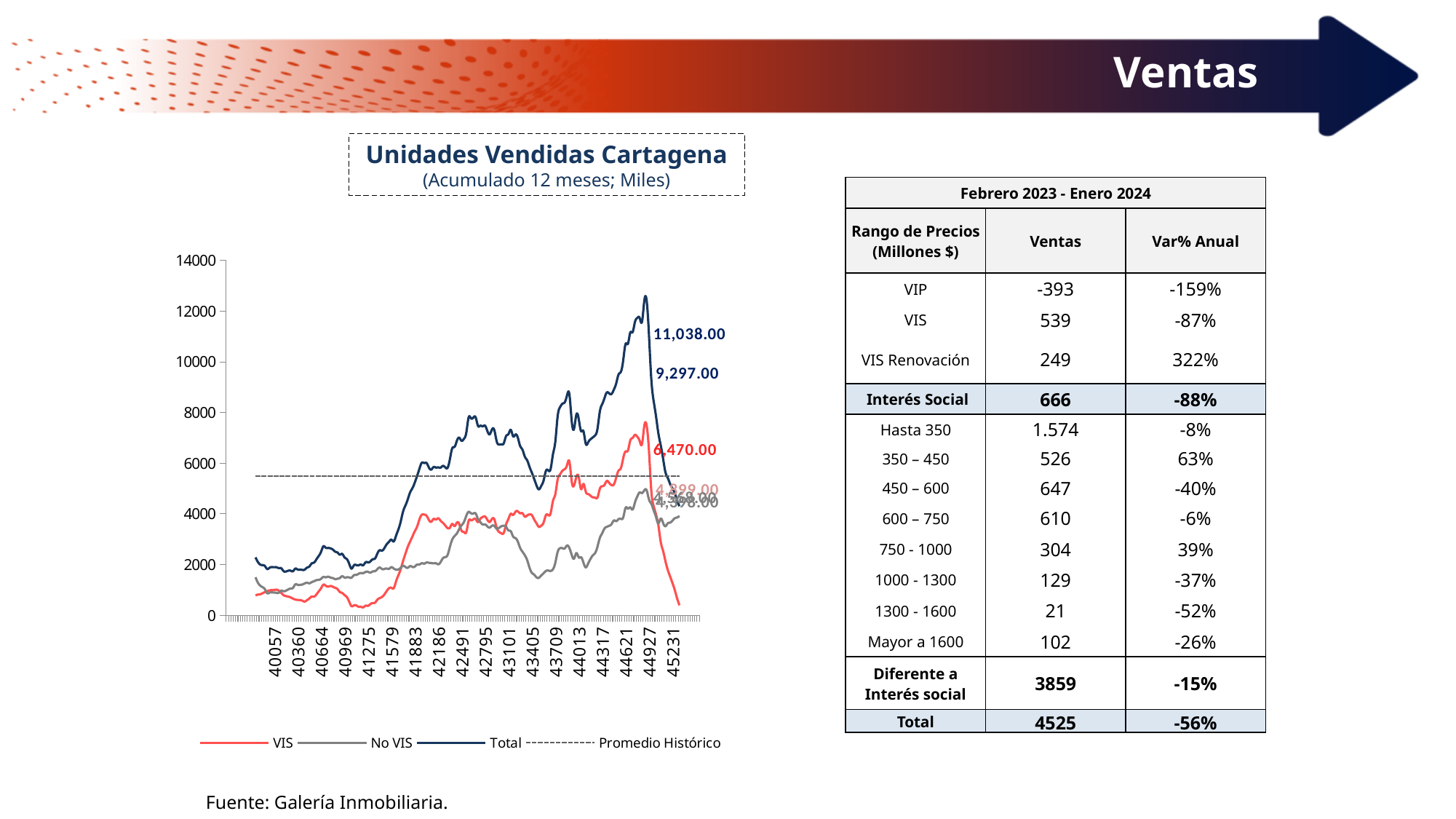
What kind of chart is shown under the title 'Unidades Vendidas Cartagena'? line chart Which legend entry in the 'Unidades Vendidas Cartagena' chart is drawn as a dashed line? Promedio Histórico Which series in the 'Unidades Vendidas Cartagena' chart carries the data label 11,038.00? Total At the far right end of the 'Unidades Vendidas Cartagena' chart, which line is higher, VIS or No VIS? No VIS Which series in the 'Unidades Vendidas Cartagena' chart carries the data label 6,470.00? VIS What is the difference between the two labelled Total values, 11,038.00 and 9,297.00, in the 'Unidades Vendidas Cartagena' chart? 1,741.00 What is the subtitle shown under the title 'Unidades Vendidas Cartagena'? (Acumulado 12 meses; Miles) Is the peak of the Total line in the 'Unidades Vendidas Cartagena' chart greater or less than 12000? greater Is the Promedio Histórico dashed line in the 'Unidades Vendidas Cartagena' chart greater or less than 4000? greater How many series does the legend of the 'Unidades Vendidas Cartagena' chart list? 4 Does the Total line in the 'Unidades Vendidas Cartagena' chart rise or fall at the far right end of the x axis? fall Which series reaches the highest value in the 'Unidades Vendidas Cartagena' chart? Total